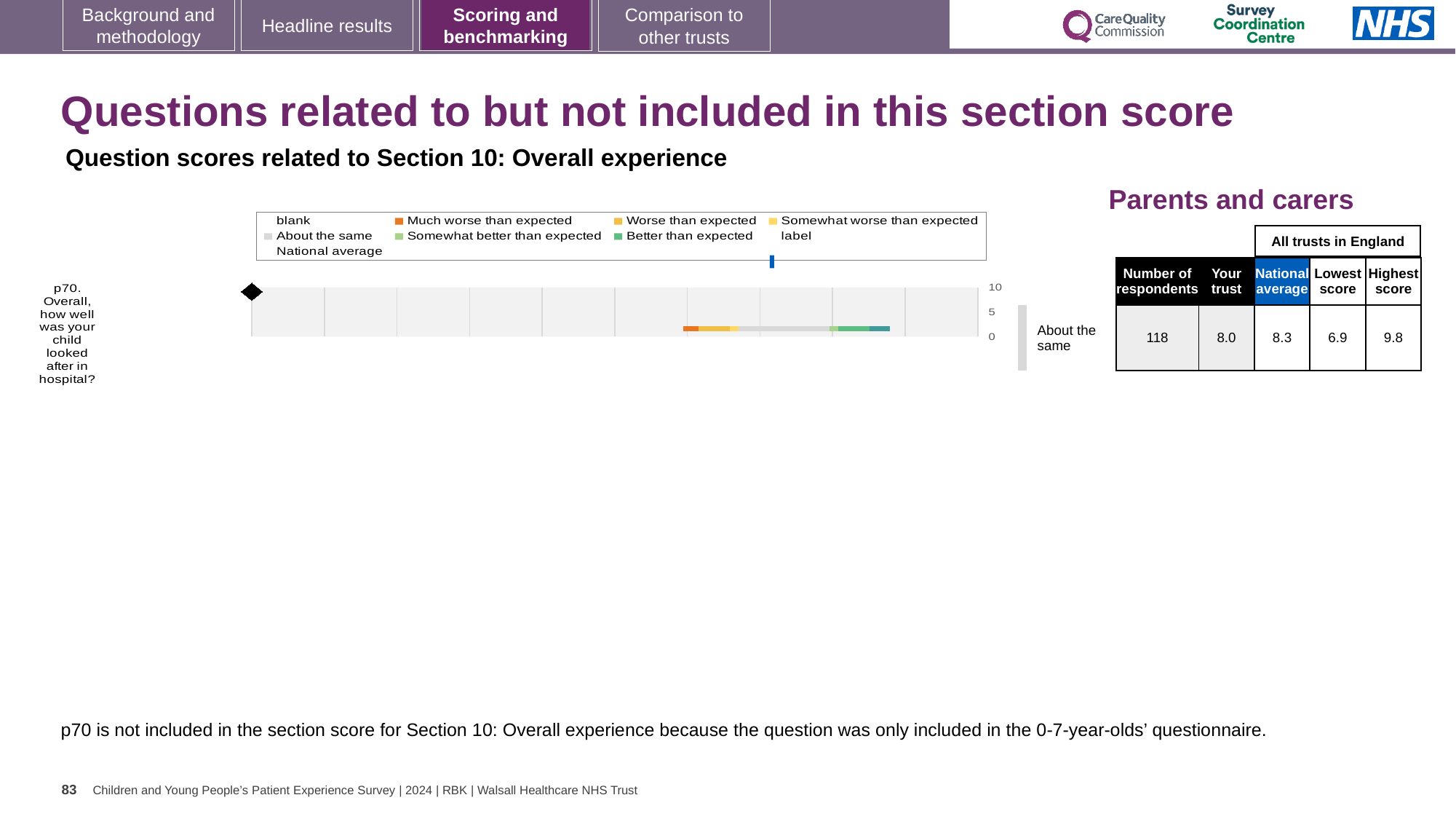
What kind of chart is used to show the p70 question score? bar chart What is the highest value shown on the chart's axis? 10 What is the lowest score among all trusts in England for p70? 6.9 Is the trust's score for p70 greater or less than 5? greater What is the highest score among all trusts in England for p70? 9.8 What is the national average score for p70? 8.3 What is the 'Your trust' score for p70 in the Parents and carers table? 8.0 How many respondents answered p70? 118 Which legend entry is shown in orange? Much worse than expected Which is larger for p70: the trust's score or the national average? National average What is the difference between the national average and the trust's score for p70? 0.3 How many questions are plotted in the chart? 1